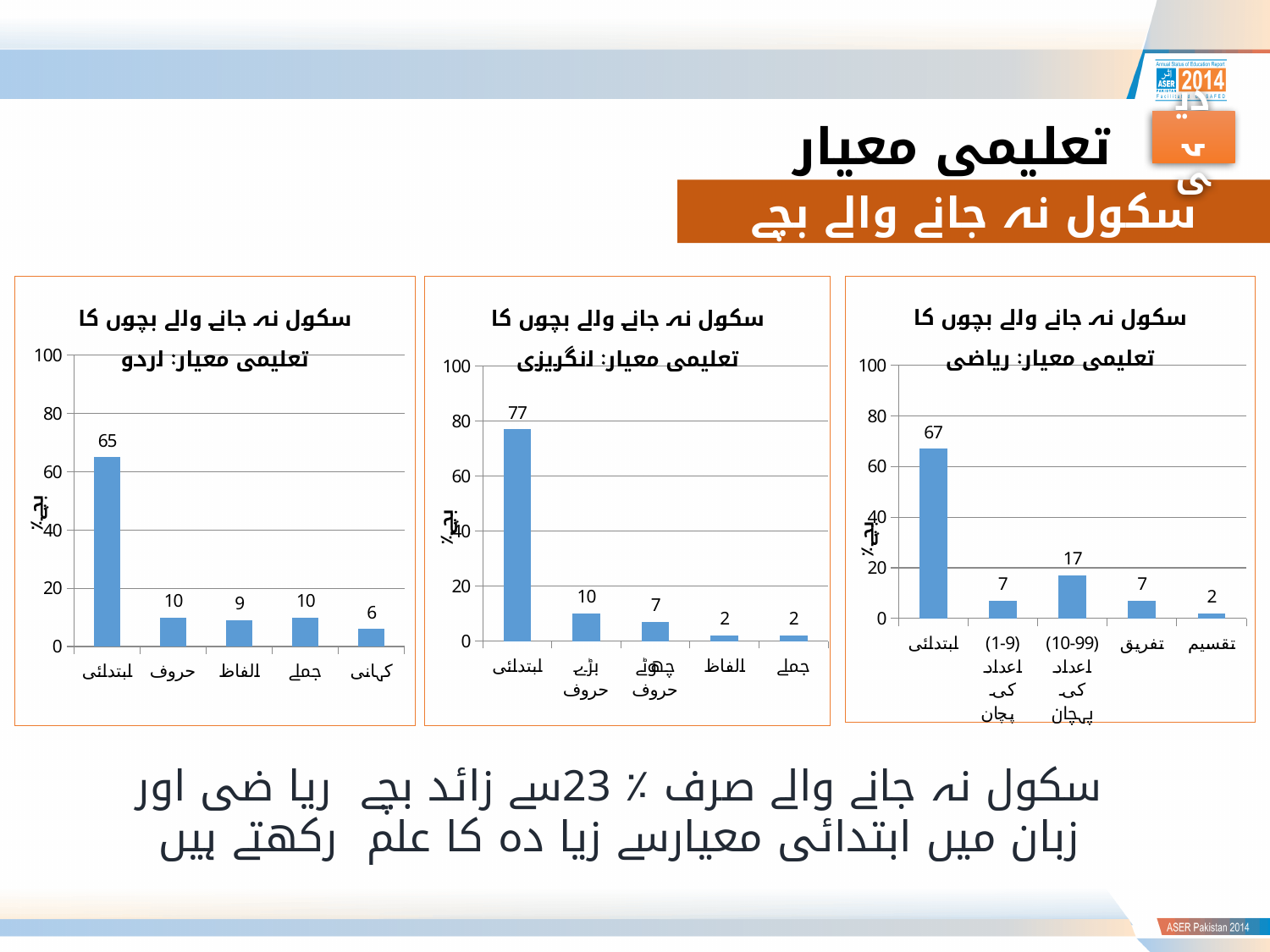
In the right chart (ریاضی), what is the value for (10-99) اعداد کی پہچان? 17 In the left chart (Urdu), which is larger, the value for الفاظ or the value for کہانی? الفاظ In the left chart (Urdu), what is the value for کہانی? 6 How many categories are shown in the middle chart (انگریزی)? 5 In the middle chart (انگریزی), what is the value for ابتدائی? 77 What kind of chart is the right chart (ریاضی)? bar chart In the middle chart (انگریزی), what is the difference between the values for ابتدائی and بڑے حروف? 67 In the left chart (Urdu), which category has the highest value? ابتدائی In the right chart (ریاضی), is the value for ابتدائی greater or less than 60? greater In the right chart (ریاضی), which category has the lowest value? تقسیم In the left chart (Urdu), what is the value for ابتدائی? 65 How many charts are shown on the slide? 3